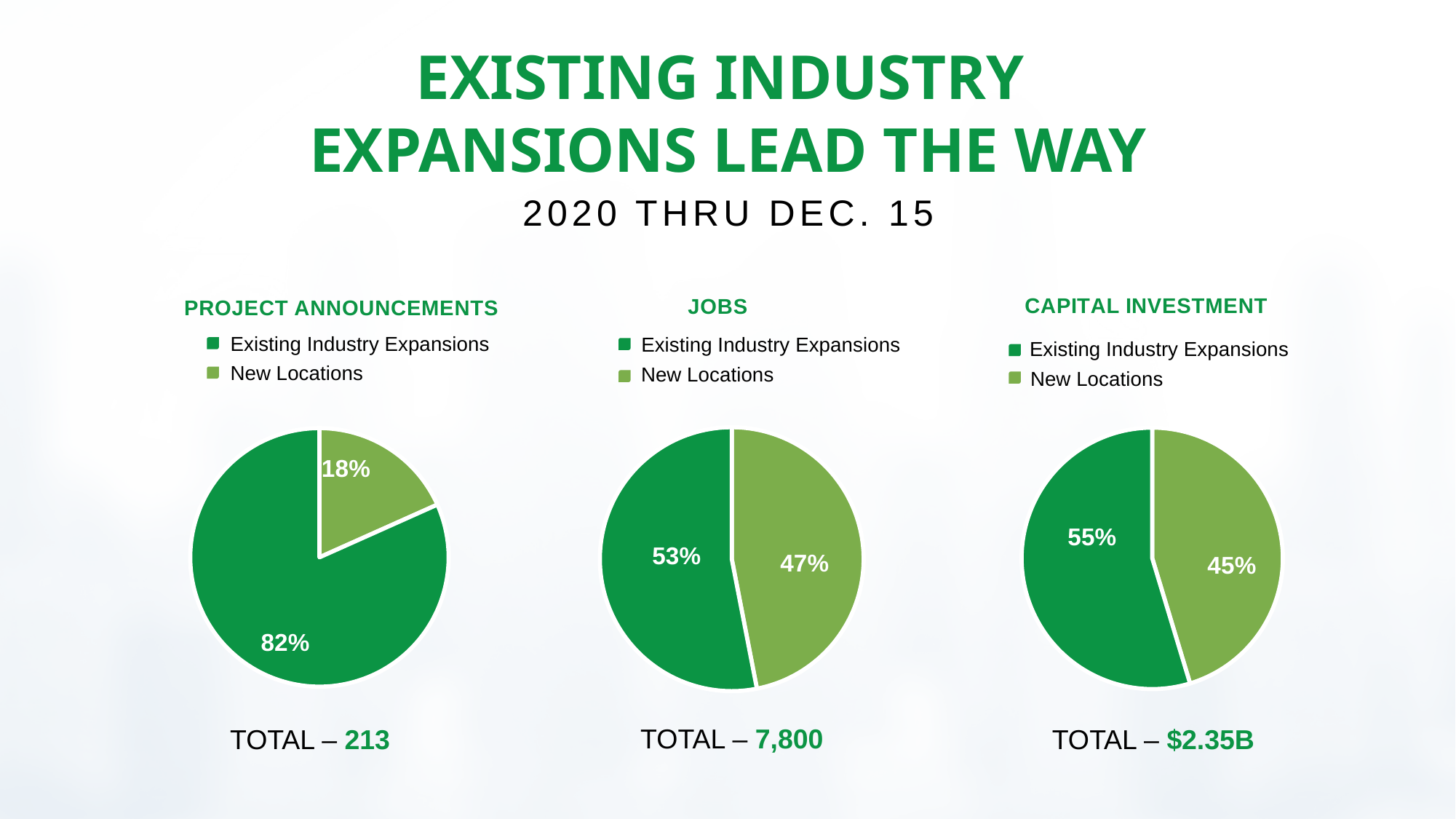
In the Project Announcements chart, what share of the pie is New Locations? 18% In the Project Announcements chart, what share of the pie is Existing Industry Expansions? 82% In the Jobs chart, what share of the pie is New Locations? 47% In the Project Announcements chart, what is the difference in percentage points between Existing Industry Expansions and New Locations? 64 In the Capital Investment chart, which slice is larger, Existing Industry Expansions or New Locations? Existing Industry Expansions What kind of chart is the Capital Investment chart? Pie chart What total is shown below the Jobs chart? 7,800 How many slices does the Jobs pie chart have? 2 What total is shown below the Capital Investment chart? $2.35B In the Jobs chart, what is the difference in percentage points between Existing Industry Expansions and New Locations? 6